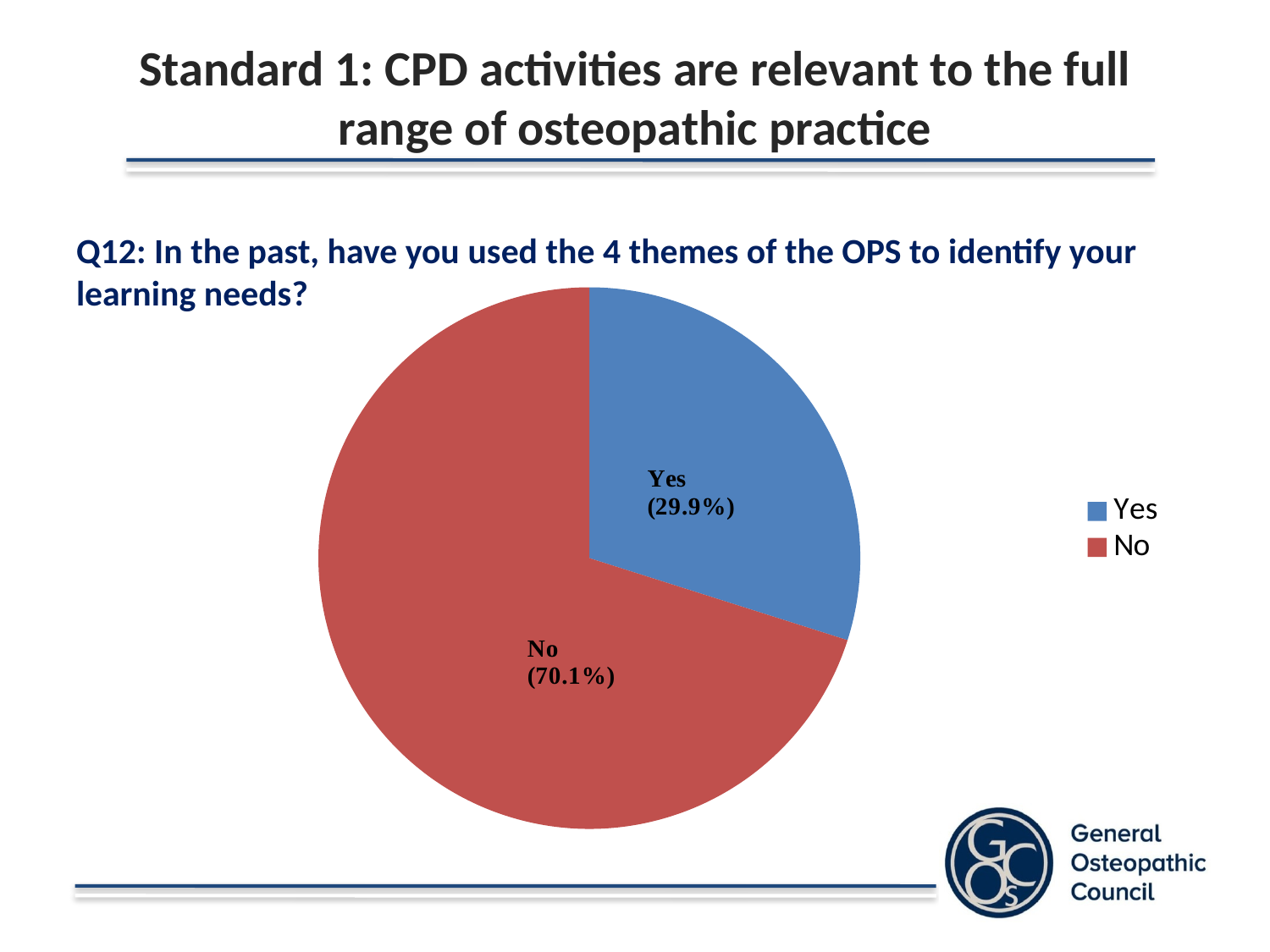
Which response has the smallest share of the pie? Yes What colour is the Yes slice? blue What percentage of respondents answered Yes? 29.9% Which is larger, the Yes share or the No share? No What percentage of respondents answered No? 70.1% What survey question does the pie chart show responses to? Q12: In the past, have you used the 4 themes of the OPS to identify your learning needs? How many slices does the pie chart have? 2 What share of the pie does the No slice represent? 70.1% What kind of chart is shown on the slide? pie chart Which response has the largest share of the pie? No What is the difference in percentage points between the No and Yes shares? 40.2 How many entries does the legend list? 2